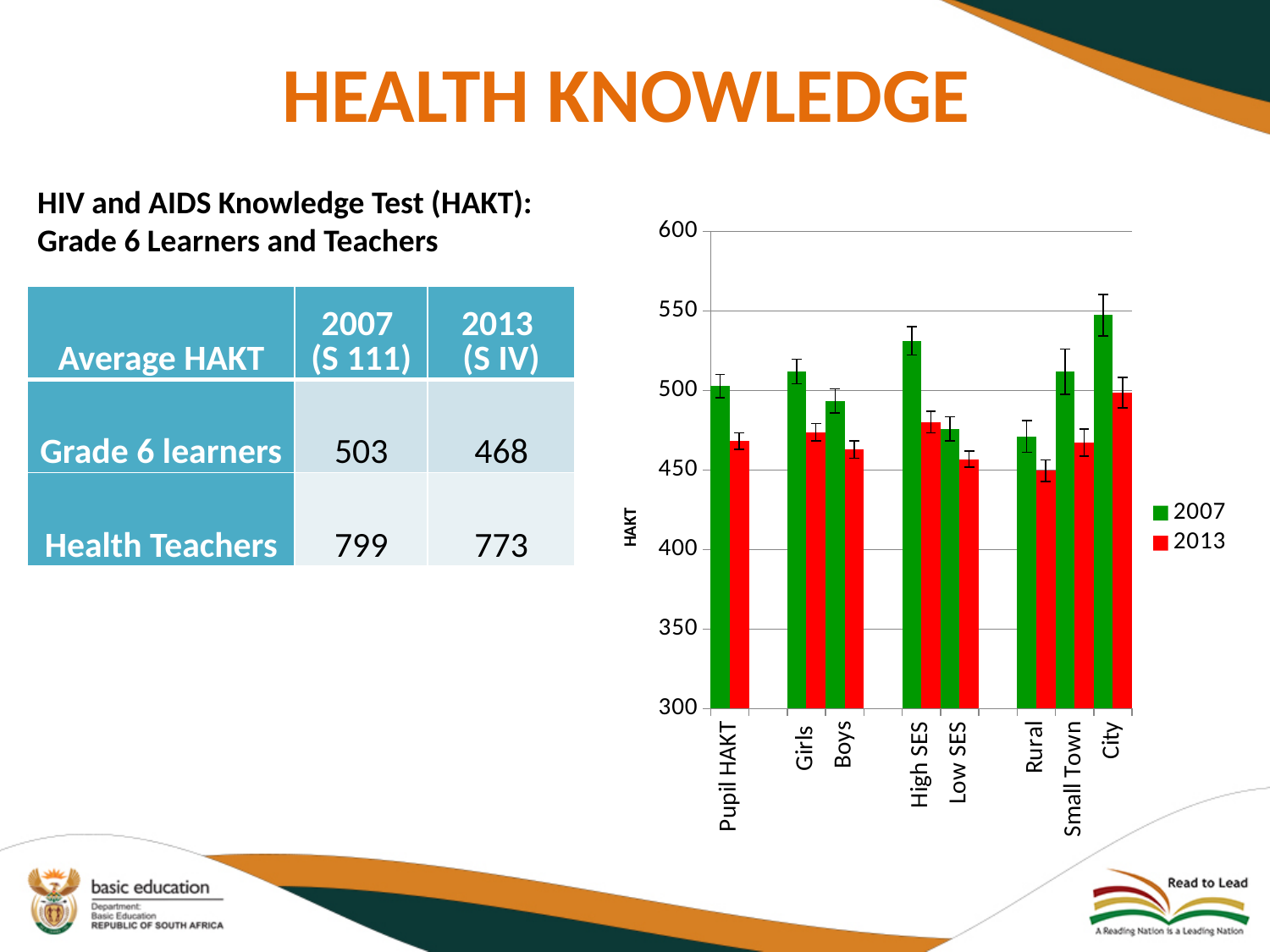
Which category has the highest 2007 value in the chart? City Is the 2007 value for High SES greater or less than 500? greater Is the 2007 value for City greater or less than 500? greater Is the 2013 value for Boys greater or less than 500? less Which category has the lowest 2007 value in the chart? Rural How many categories are shown along the x axis of the chart? 8 How many series does the chart's legend list? 2 What kind of chart is shown on the slide? bar chart For Girls, which series has the larger value, 2007 or 2013? 2007 Which category has the highest 2013 value in the chart? City What label is shown on the vertical axis of the chart? HAKT